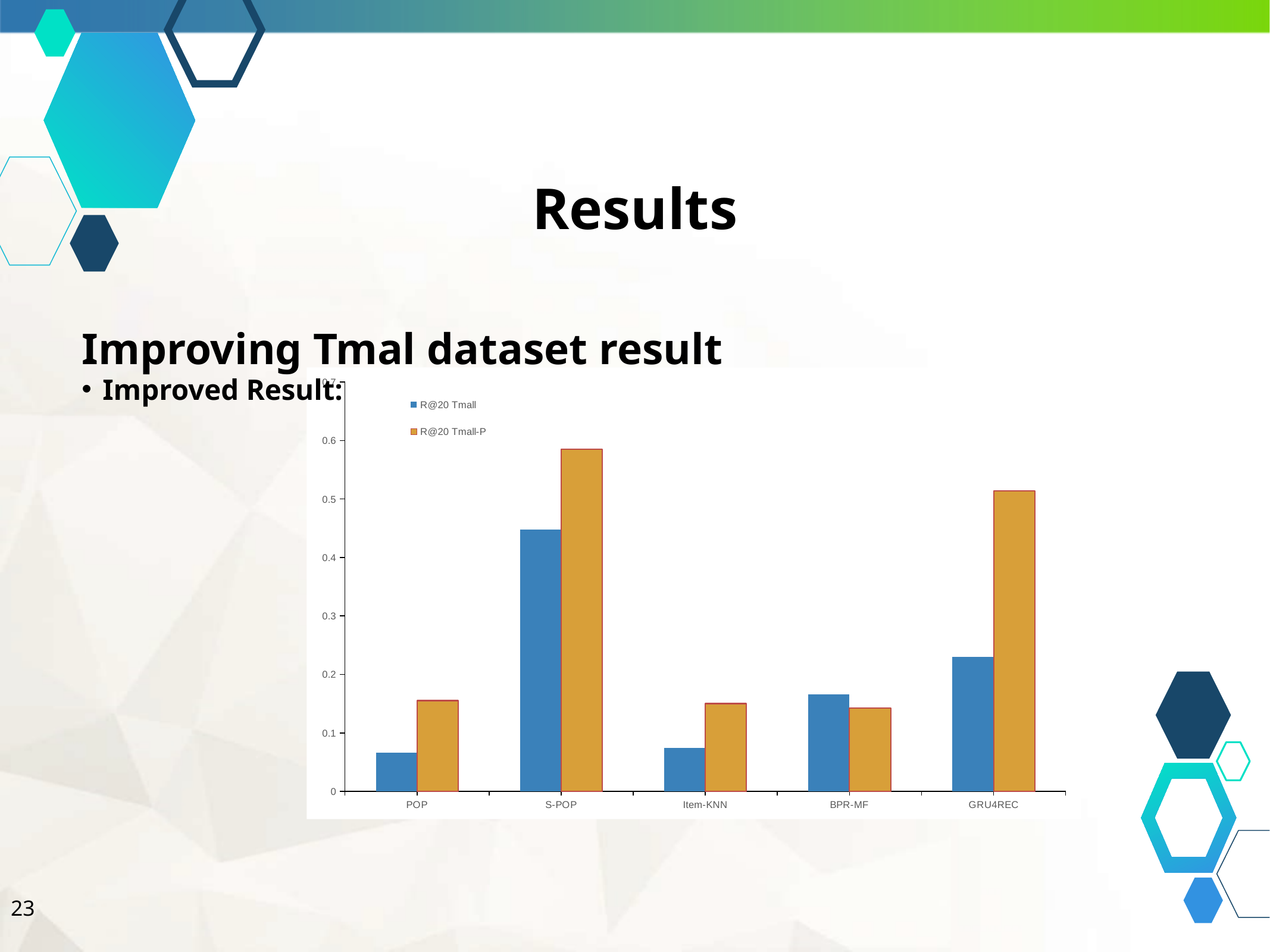
Which category has the highest value for R@20 Tmall? S-POP Which series is shown in orange in the legend? R@20 Tmall-P What kind of chart is shown on the slide? bar chart Which category has the highest value for R@20 Tmall-P? S-POP Is the R@20 Tmall value for POP greater or less than 0.1? less Is the R@20 Tmall value for S-POP greater or less than 0.4? greater Is the R@20 Tmall-P value for S-POP greater or less than 0.5? greater How many series does the legend list? 2 How many categories are shown on the x axis? 5 For POP, which is larger: the R@20 Tmall value or the R@20 Tmall-P value? R@20 Tmall-P